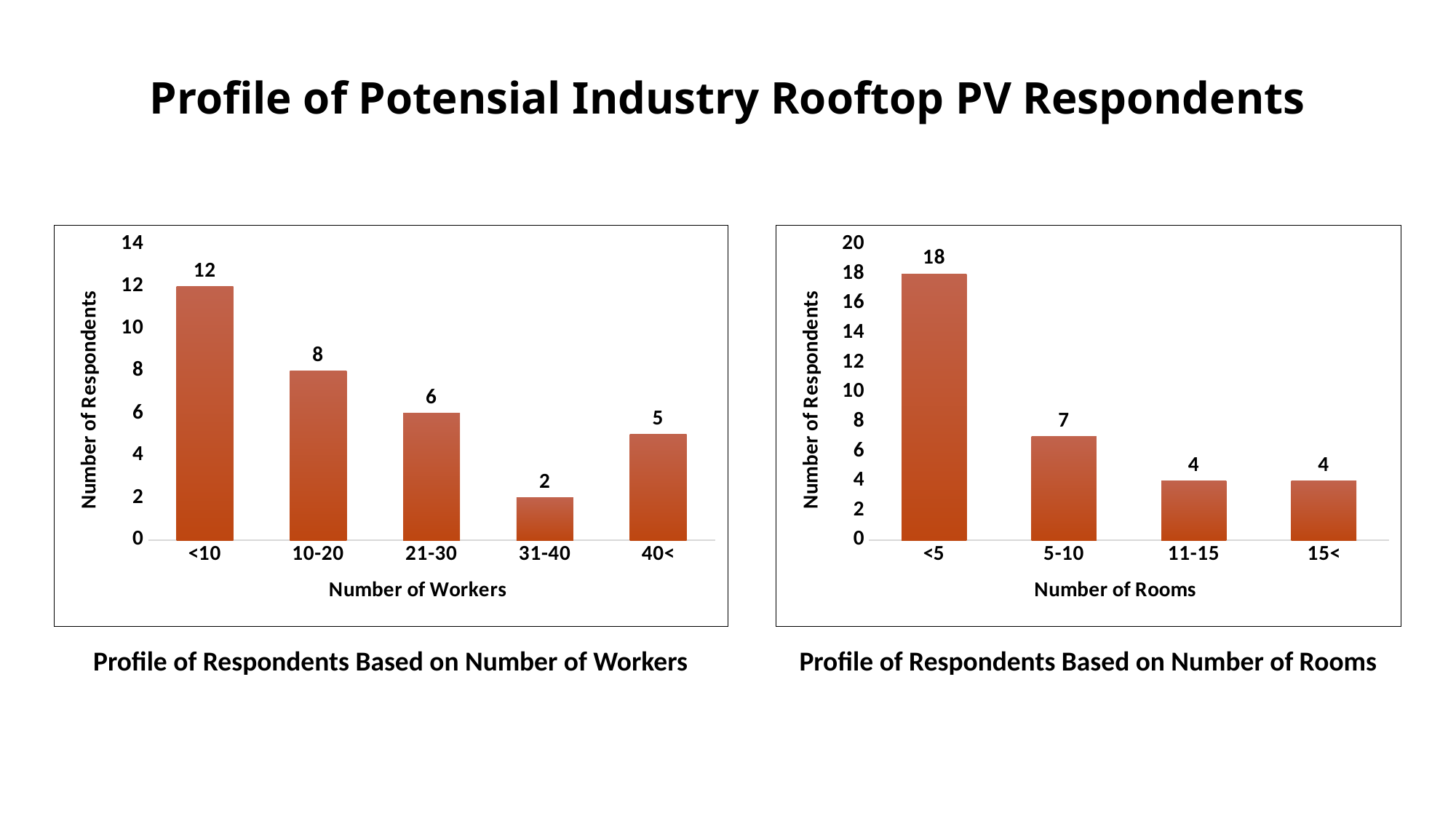
In the 'Profile of Respondents Based on Number of Rooms' chart, how many room categories are shown on the x axis? 4 In the 'Profile of Respondents Based on Number of Workers' chart, which has more respondents: 40< workers or 31-40 workers? 40< In the 'Profile of Respondents Based on Number of Rooms' chart, which room category has the highest number of respondents? <5 In the 'Profile of Respondents Based on Number of Rooms' chart, what is the difference between the number of respondents for <5 rooms and 5-10 rooms? 11 What type of chart is the 'Profile of Respondents Based on Number of Rooms' chart? Bar chart In the 'Profile of Respondents Based on Number of Workers' chart, how many respondents have fewer than 10 workers (<10)? 12 What is the y-axis label of the 'Profile of Respondents Based on Number of Workers' chart? Number of Respondents In the 'Profile of Respondents Based on Number of Workers' chart, which worker category has the lowest number of respondents? 31-40 In the 'Profile of Respondents Based on Number of Rooms' chart, how many respondents have fewer than 5 rooms (<5)? 18 In the 'Profile of Respondents Based on Number of Workers' chart, what is the difference between the number of respondents for 10-20 workers and 21-30 workers? 2 In the 'Profile of Respondents Based on Number of Workers' chart, how many worker categories are shown on the x axis? 5 In the 'Profile of Respondents Based on Number of Rooms' chart, how many respondents have 11-15 rooms? 4